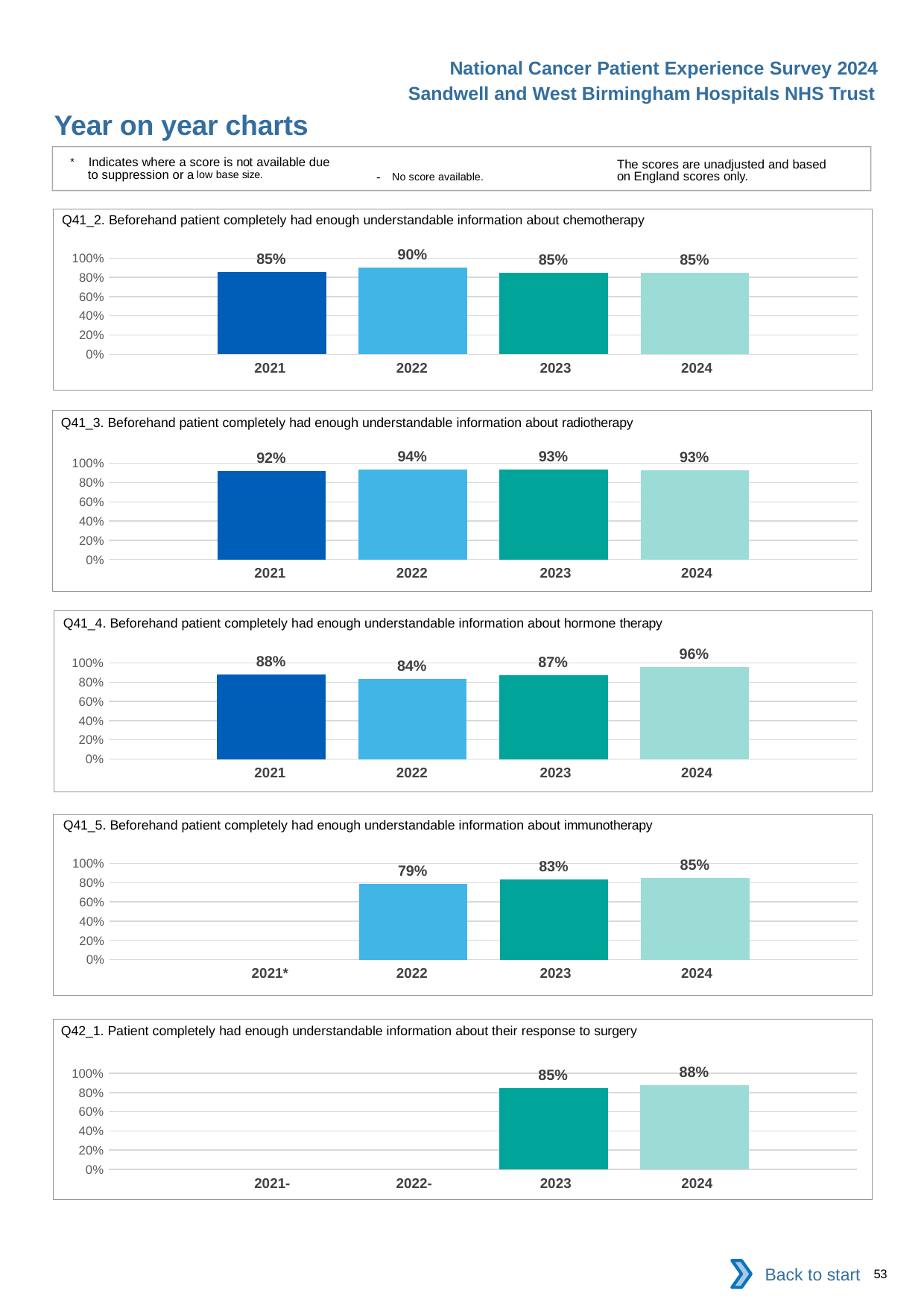
In the Q42_1 chart (response to surgery), which is larger, the value for 2023 or 2024? 2024 In the Q41_2 chart (chemotherapy), what is the value for 2022? 90% In the Q41_3 chart (radiotherapy), which year has the highest value? 2022 In the Q41_4 chart (hormone therapy), which year has the lowest value? 2022 In the Q41_4 chart (hormone therapy), what is the difference between the 2024 and 2022 values? 12 percentage points In the Q41_5 chart (immunotherapy), what is the value for 2023? 83% In the Q42_1 chart (response to surgery), what is the value for 2024? 88% What kind of chart is the Q41_2 chart (chemotherapy)? bar chart In the Q41_5 chart (immunotherapy), do the values rise or fall from 2022 to 2024? rise In the Q41_5 chart (immunotherapy), how many years have a bar plotted? 3 In the Q41_3 chart (radiotherapy), what is the difference between the 2022 and 2021 values? 2 percentage points How many charts are shown on the slide? 5